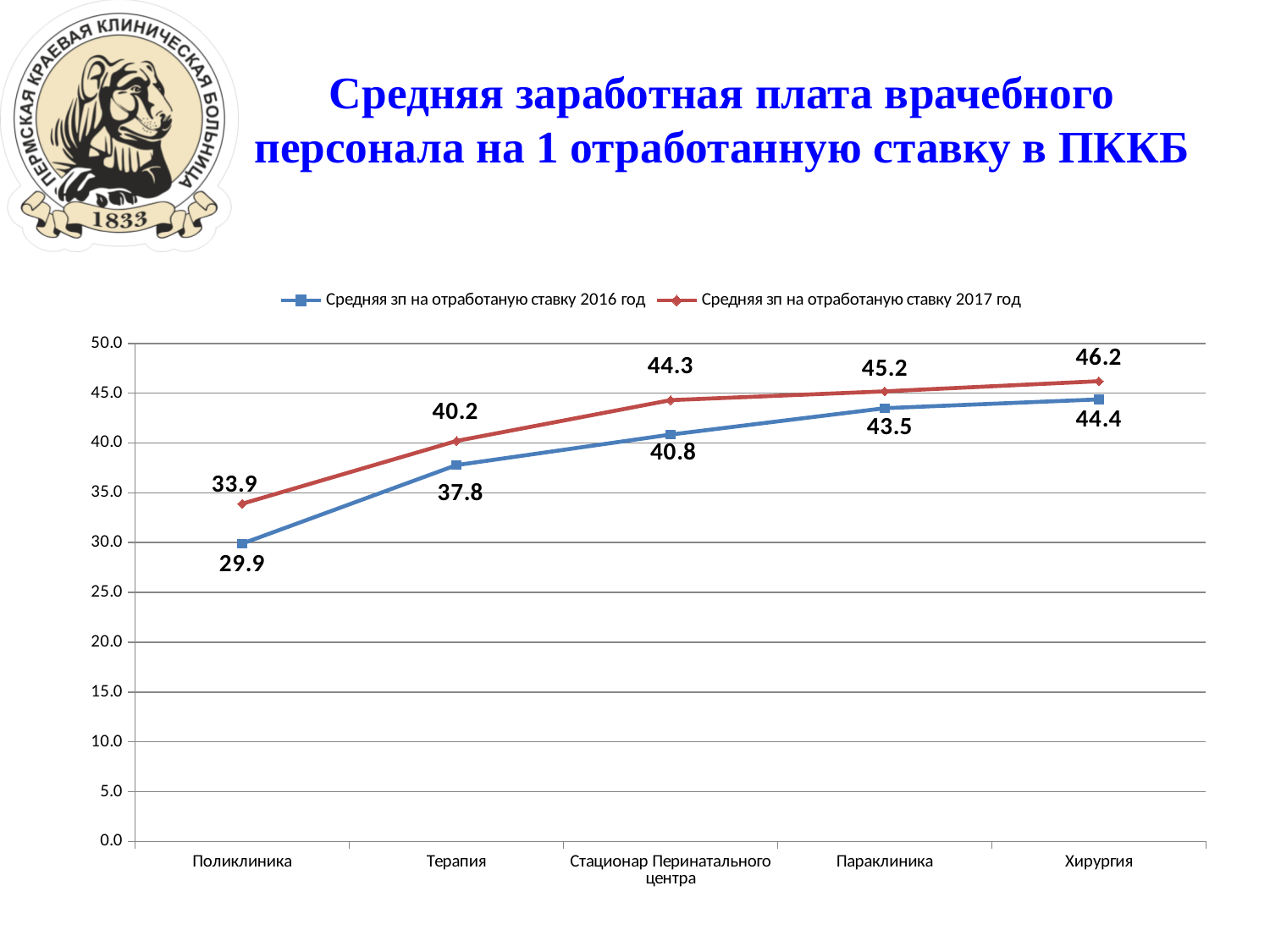
Is the 2016 value for Терапия greater or less than 40.0? less What kind of chart is shown on the slide? line chart Which is larger: the 2016 value for Параклиника or the 2017 value for Терапия? 2016 value for Параклиника Which category has the lowest value in the 2017 series? Поликлиника What is the value for Хирургия in the 2017 series (Средняя зп на отработаную ставку 2017 год)? 46.2 Which category has the highest value in the 2016 series? Хирургия What is the value for Поликлиника in the 2016 series (Средняя зп на отработаную ставку 2016 год)? 29.9 How many series does the legend list? 2 What is the value for Терапия in the 2017 series? 40.2 How many categories are shown on the x axis? 5 What is the difference between the 2017 and 2016 values for Стационар Перинатального центра? 3.5 What is the difference between the 2017 and 2016 values for Поликлиника? 4.0